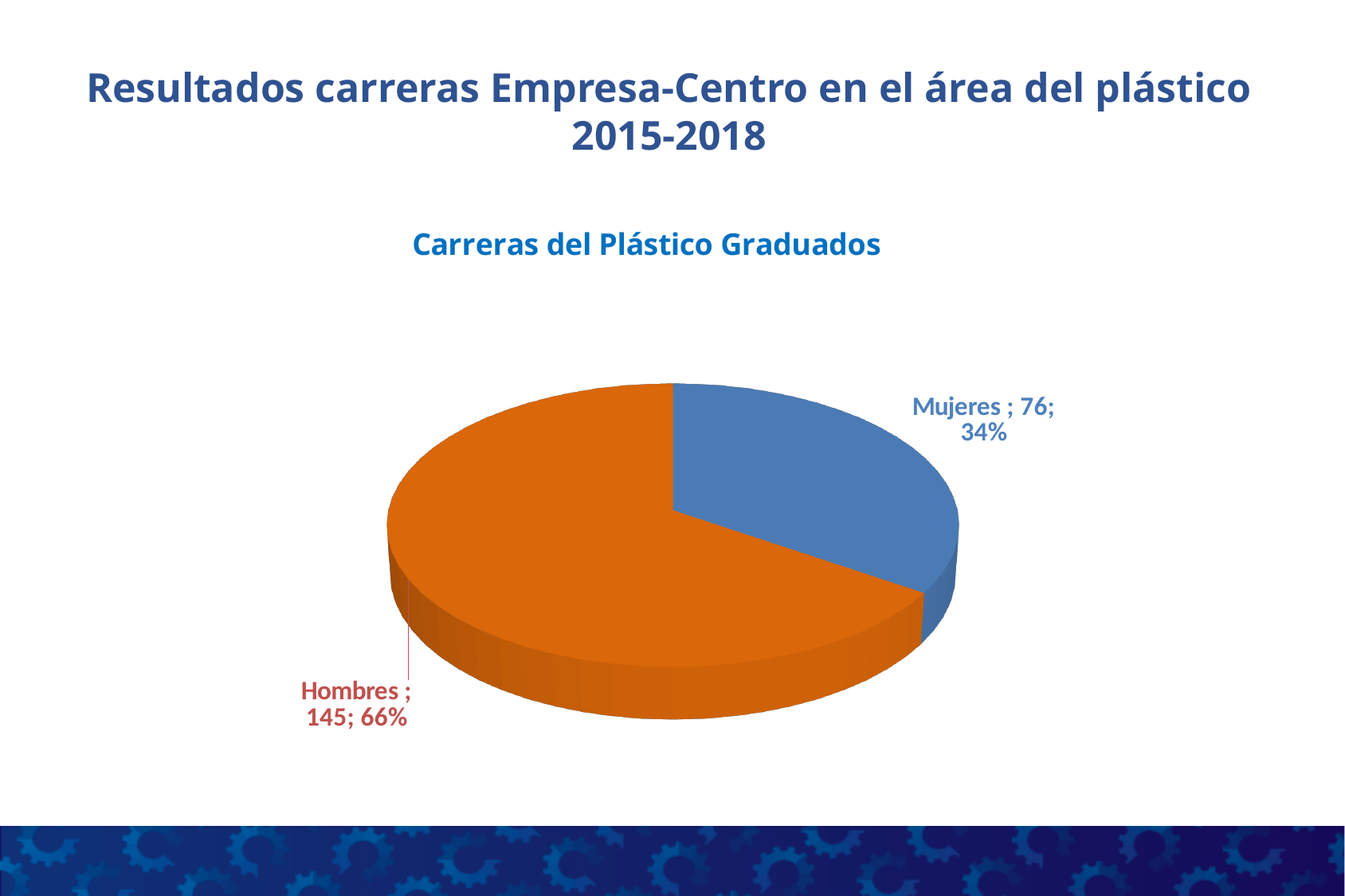
What is the title of the chart? Carreras del Plástico Graduados What is the value for Mujeres? 76 What share of the pie does Mujeres represent? 34% What share of the pie does Hombres represent? 66% What is the difference between the values for Hombres and Mujeres? 69 What kind of chart is shown on the slide? pie chart Which category has the smallest slice? Mujeres How many slices does the pie chart have? 2 What is the value for Hombres? 145 What colour is the Mujeres slice? blue Which category has the largest slice? Hombres Which is larger, the value for Hombres or the value for Mujeres? Hombres